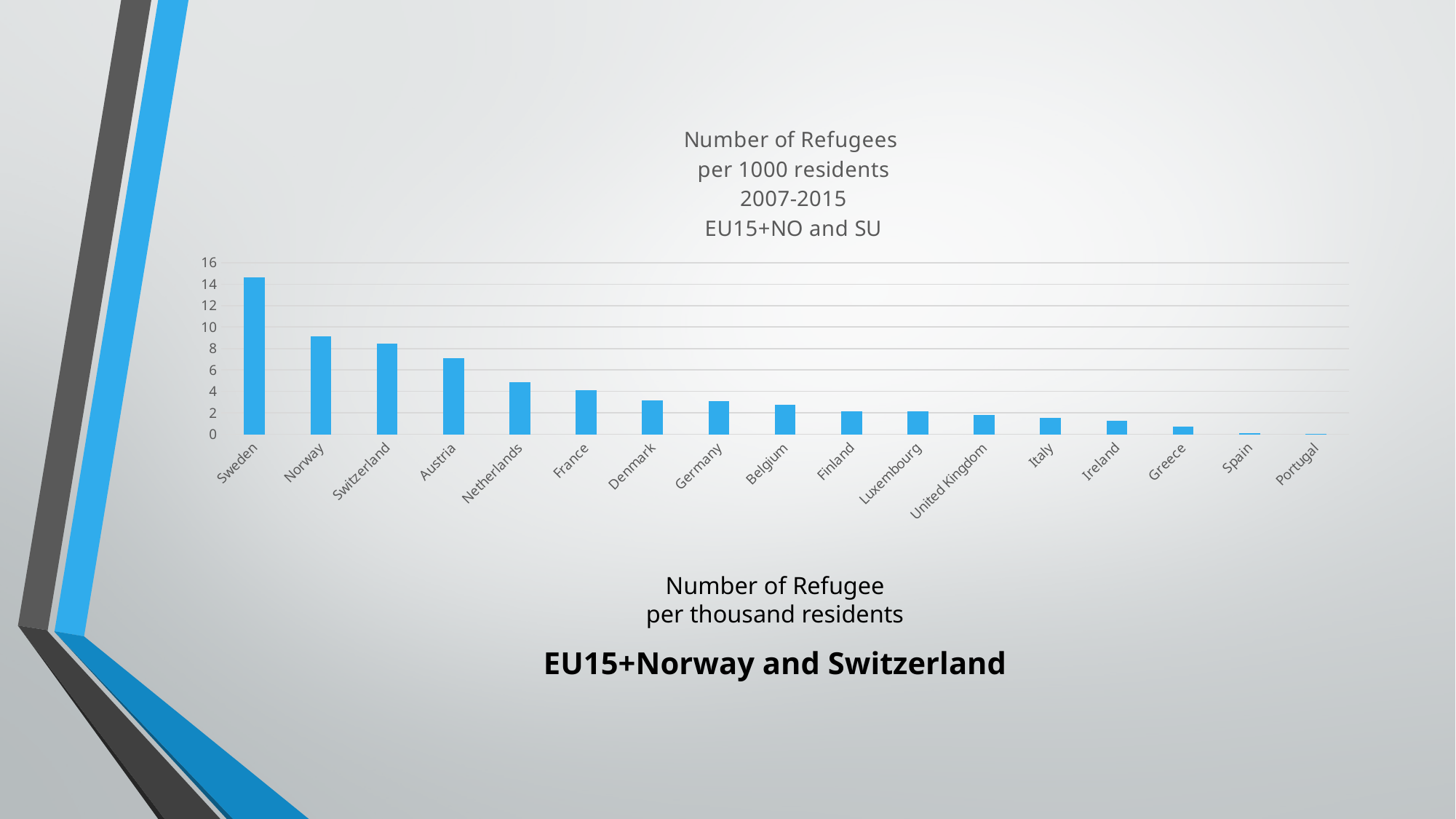
Is the value for Netherlands greater or less than 4? greater Is the value for Sweden greater or less than 14? greater How many countries are shown on the x axis of the chart? 17 Which has a higher value, Austria or Netherlands? Austria Which country has the highest number of refugees per 1000 residents? Sweden What kind of chart is shown on the slide? bar chart What period is given in the chart title? 2007-2015 Is the value for Norway greater or less than 8? greater Do the values rise or fall moving from left to right along the x axis? fall Which has a higher value, Norway or Switzerland? Norway